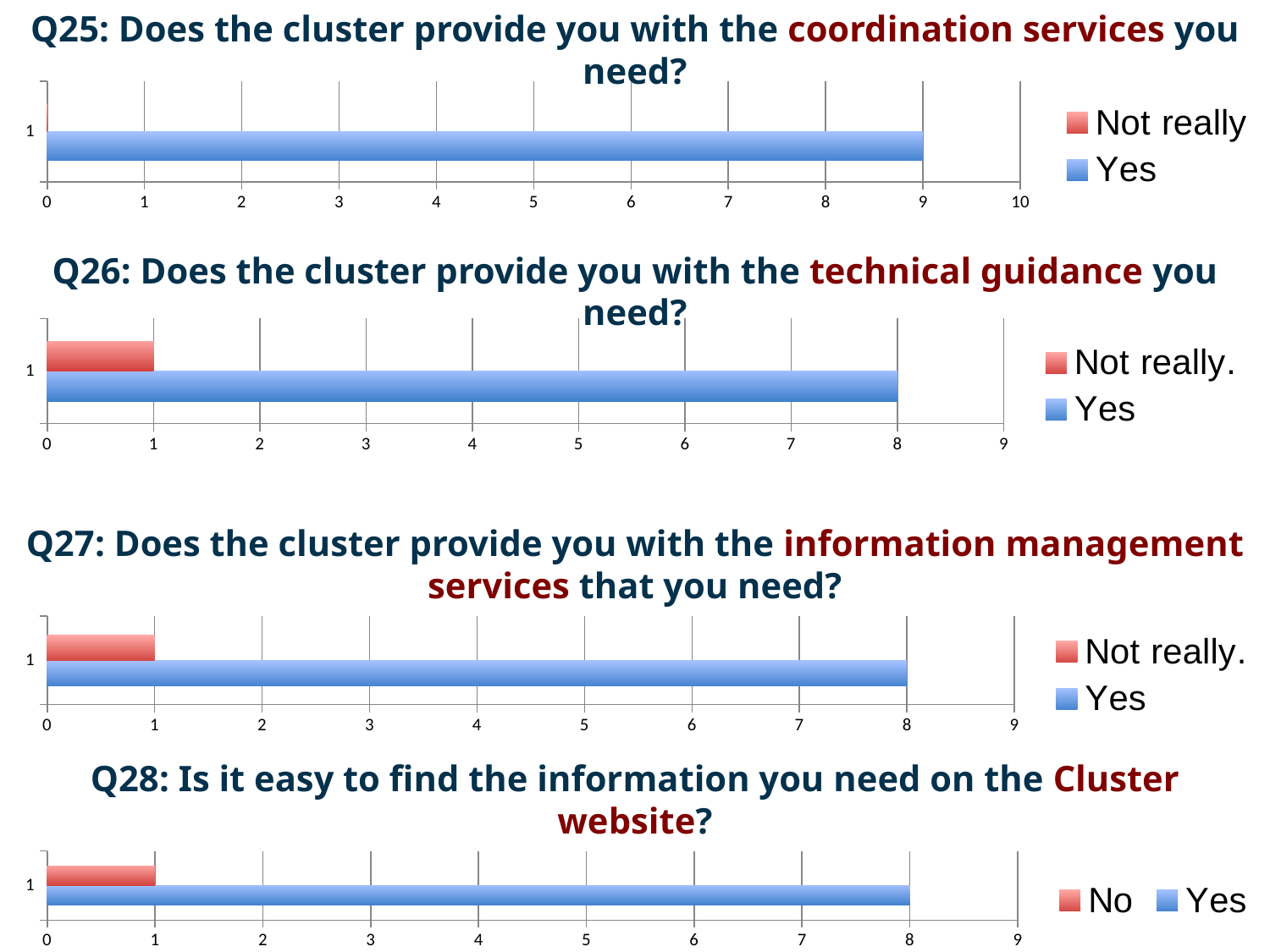
In the Q27 chart (information management services), what is the value for Yes? 8 In the Q28 chart (Cluster website), what is the value for No? 1 In the Q26 chart (technical guidance), what is the value for Not really? 1 In the Q25 chart (coordination services), what is the value for Yes? 9 In the Q28 chart (Cluster website), what colour is the Yes bar? blue In the Q26 chart (technical guidance), is the value for Yes greater or less than 5? greater In the Q28 chart (Cluster website), what is the difference between Yes and No? 7 In the Q26 chart (technical guidance), what is the value for Yes? 8 How many charts are shown on the slide? 4 What kind of chart is the Q28 chart (Cluster website)? bar chart How many series does the legend of the Q25 chart (coordination services) list? 2 In the Q27 chart (information management services), which series is larger, Yes or Not really? Yes